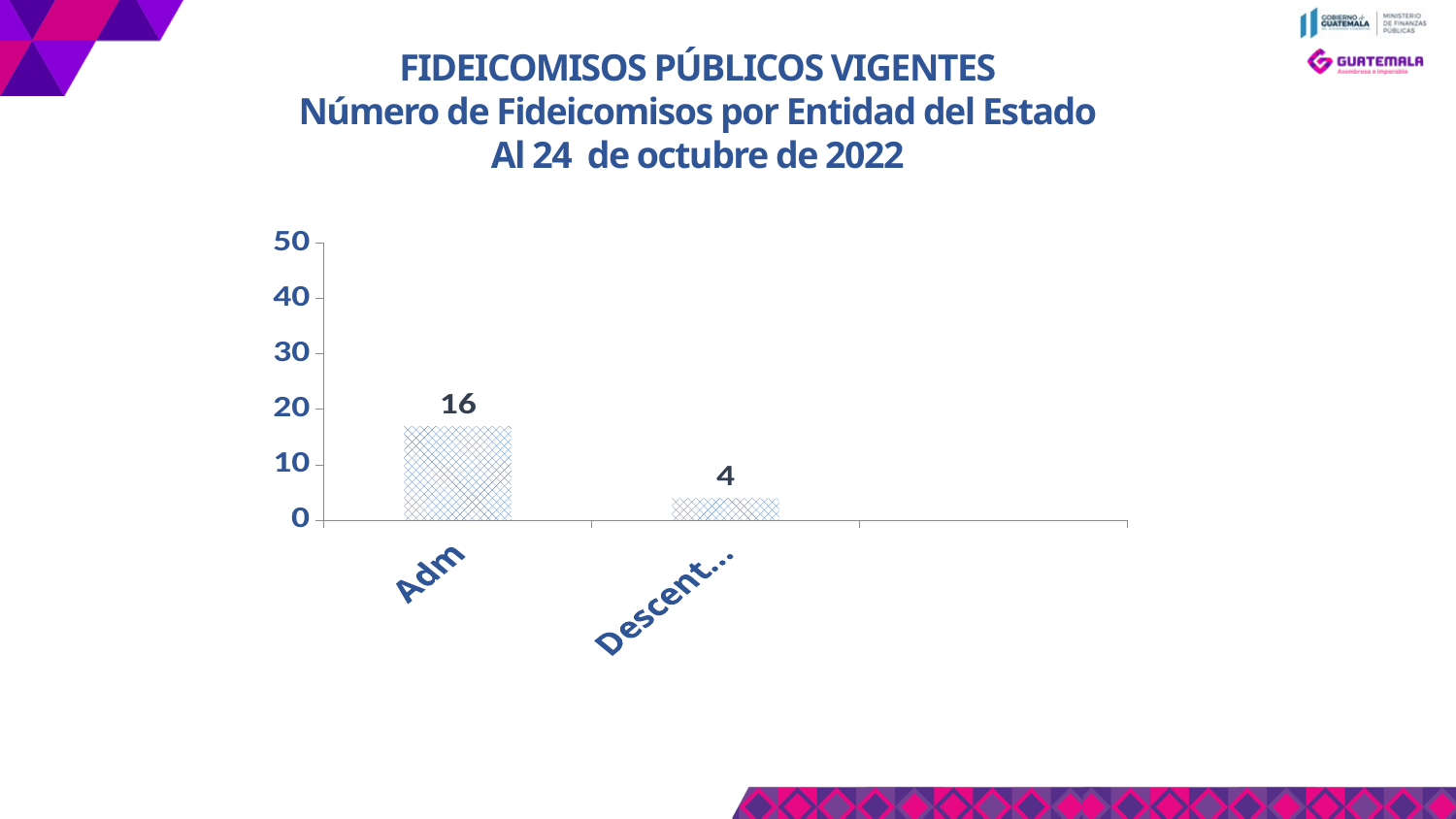
Is the value for "Adm" greater or less than 20? less What is the maximum value shown on the vertical axis? 50 What is the difference between the values for "Adm" and "Descent..."? 12 What is the value of the bar labelled "Descent..."? 4 How many bars are plotted in the chart? 2 Which is larger, the value for "Adm" or the value for "Descent..."? Adm Which category has the highest value? Adm What type of chart is shown on the slide? bar chart What is the value of the bar labelled "Adm"? 16 Is the value for "Descent..." greater or less than 10? less Which category has the lowest value? Descent... What date does the chart title say the data is as of? 24 de octubre de 2022